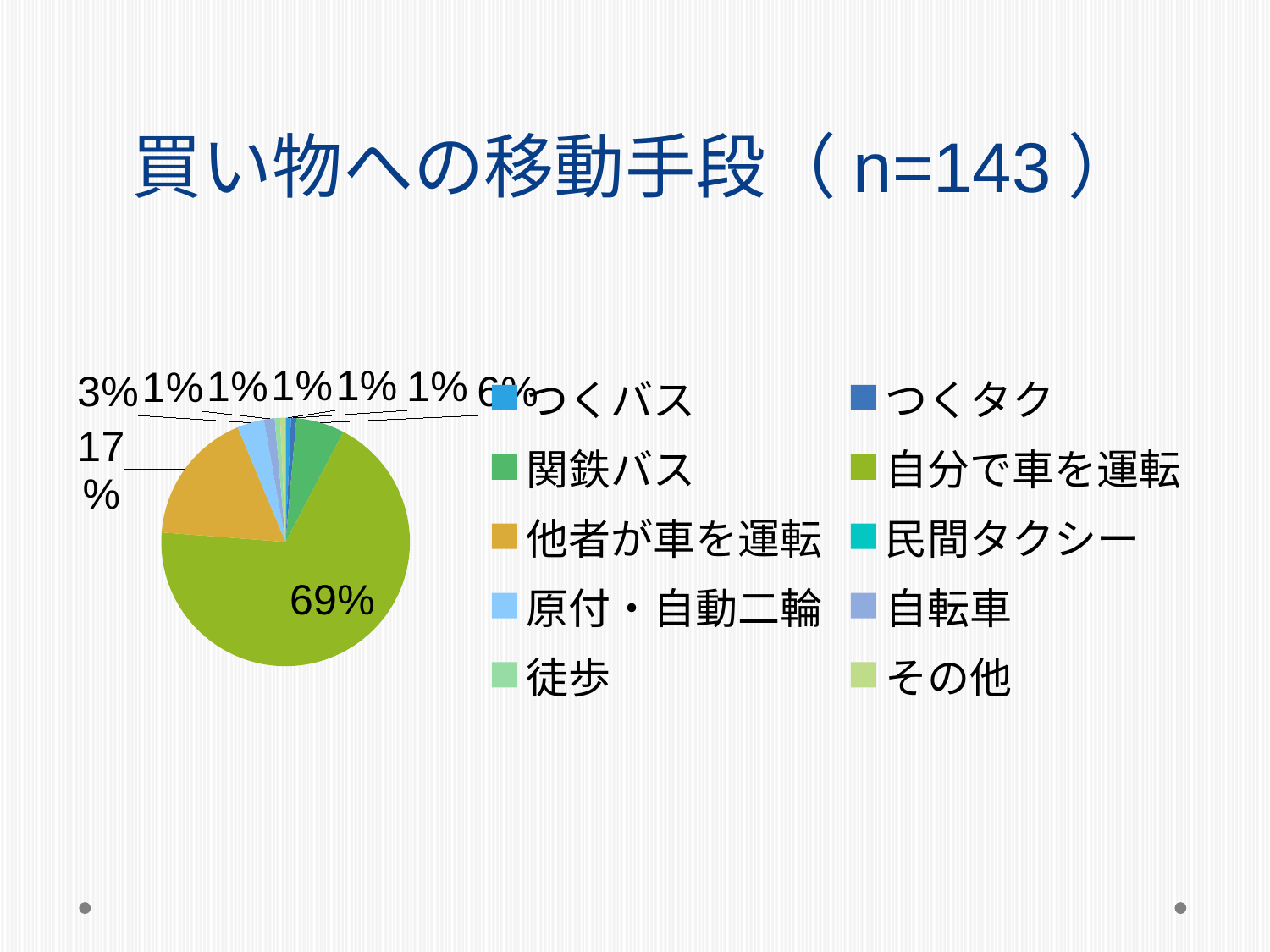
What kind of chart is shown on the slide? pie chart What share of the pie is 自分で車を運転? 69% How many entries does the legend list? 10 What share of the pie is 他者が車を運転? 17% Which is larger, 他者が車を運転 or 原付・自動二輪? 他者が車を運転 What is the sample size (n) given in the chart title? 143 Which category has the largest slice of the pie? 自分で車を運転 Which is larger, 自分で車を運転 or 他者が車を運転? 自分で車を運転 What is the difference in percentage points between 自分で車を運転 and 他者が車を運転? 52 What is the title of the chart? 買い物への移動手段（n=143） What share of the pie is 原付・自動二輪? 3%